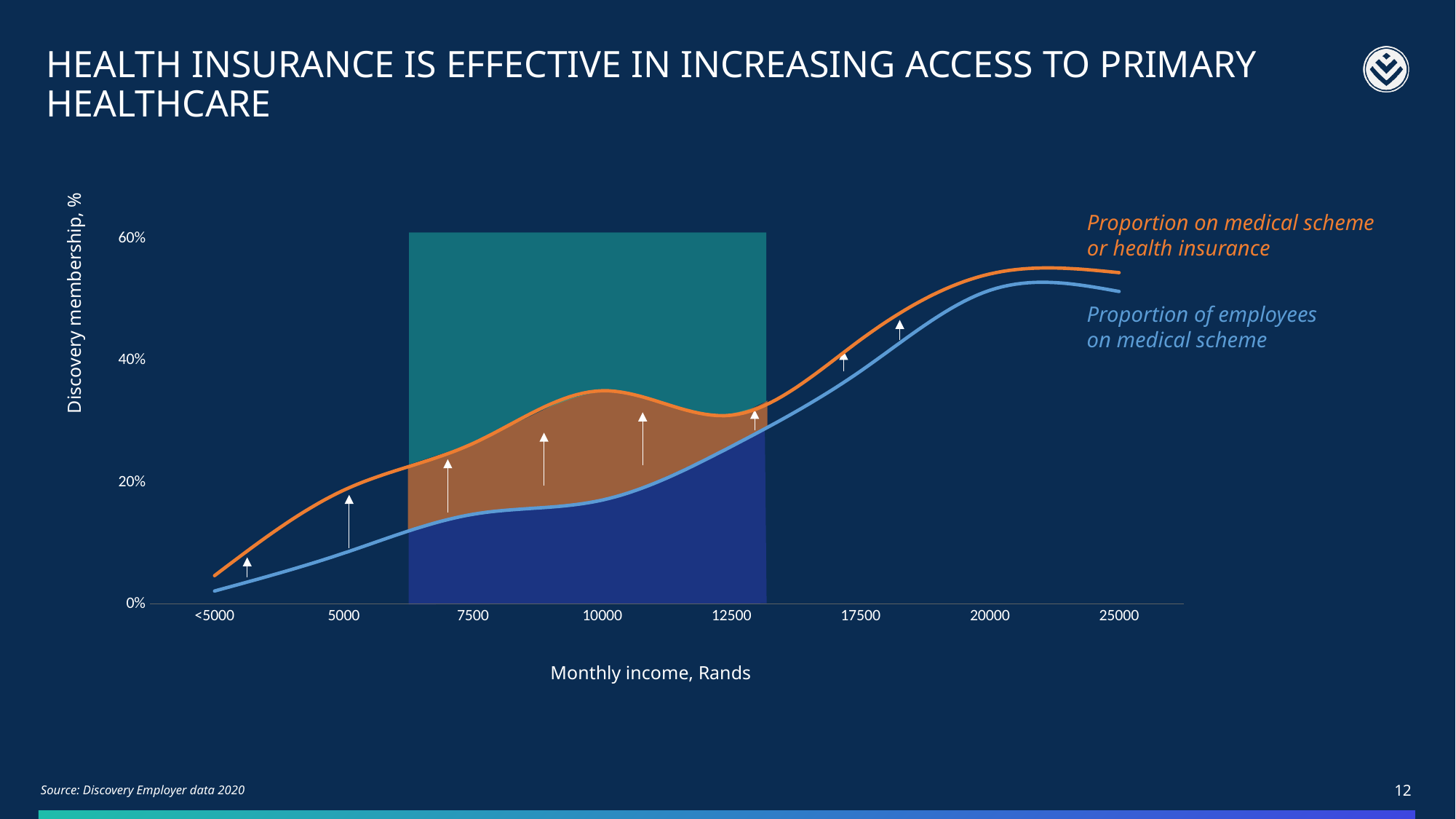
Is the value for 'Proportion of employees on medical scheme' at 10000 greater or less than 20%? less Is the value for 'Proportion of employees on medical scheme' at <5000 greater or less than 20%? less What kind of chart is shown on the slide? line chart What is the title of the x axis? Monthly income, Rands How many income categories are labelled on the x axis? 8 Is the value for 'Proportion on medical scheme or health insurance' at 20000 greater or less than 40%? greater Do the values for 'Proportion of employees on medical scheme' generally rise or fall as monthly income increases from <5000 to 20000? rise At 10000, which series has the larger value: 'Proportion on medical scheme or health insurance' or 'Proportion of employees on medical scheme'? Proportion on medical scheme or health insurance How many series are plotted on the chart? 2